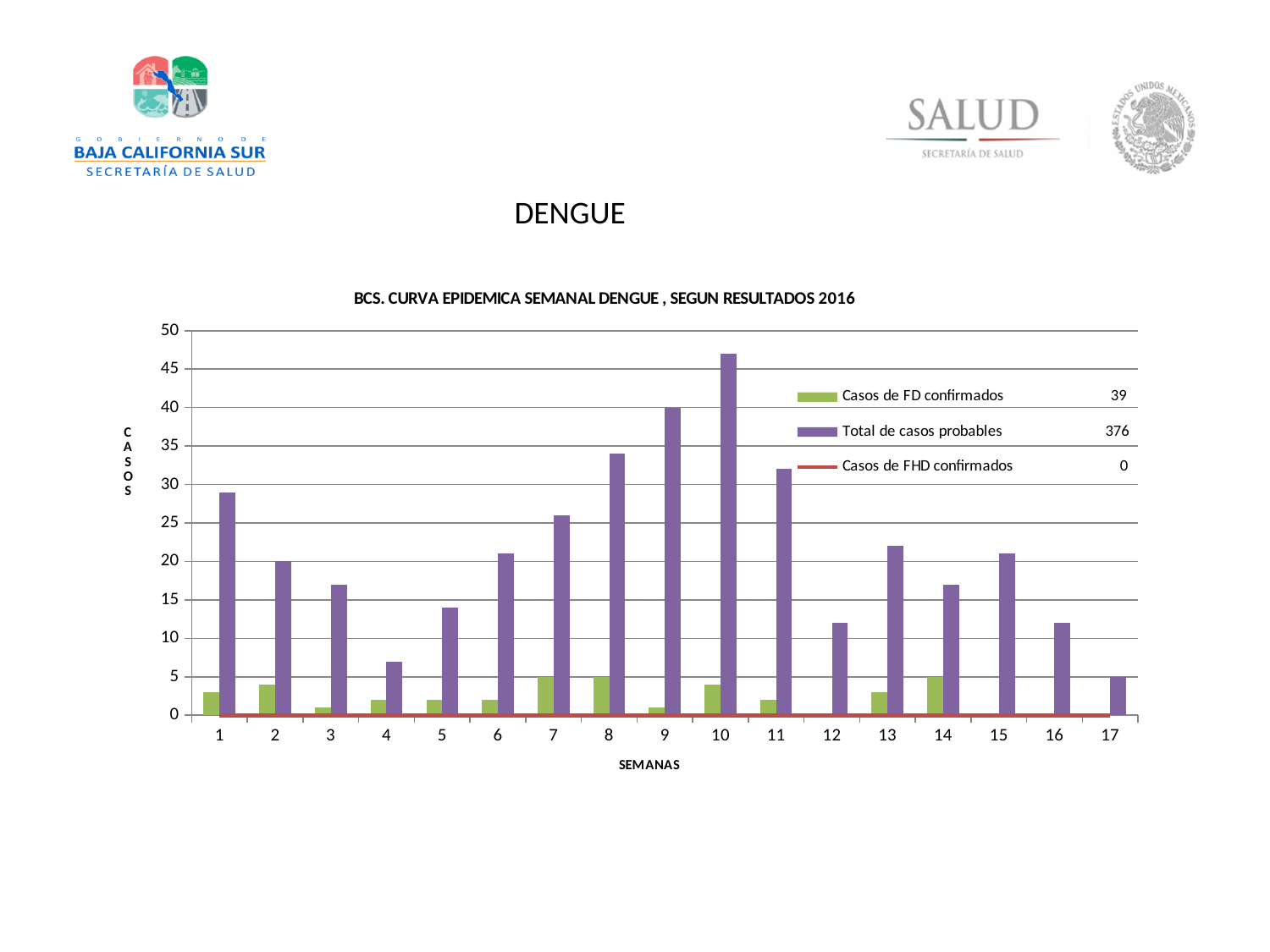
Which week has a larger Total de casos probables, week 9 or week 11? 9 Does the Total de casos probables rise or fall from week 4 to week 10? rise Is the Total de casos probables for week 10 greater or less than 45? greater What total is shown in the legend for Total de casos probables? 376 How many weeks (semanas) are shown on the x axis? 17 What is the title of the chart? BCS. CURVA EPIDEMICA SEMANAL DENGUE , SEGUN RESULTADOS 2016 What total is shown in the legend for Casos de FD confirmados? 39 How many series does the legend list? 3 What total is shown in the legend for Casos de FHD confirmados? 0 In which week is the Total de casos probables lowest? 17 In which week is the Total de casos probables highest? 10 What kind of chart is shown on the slide? bar chart